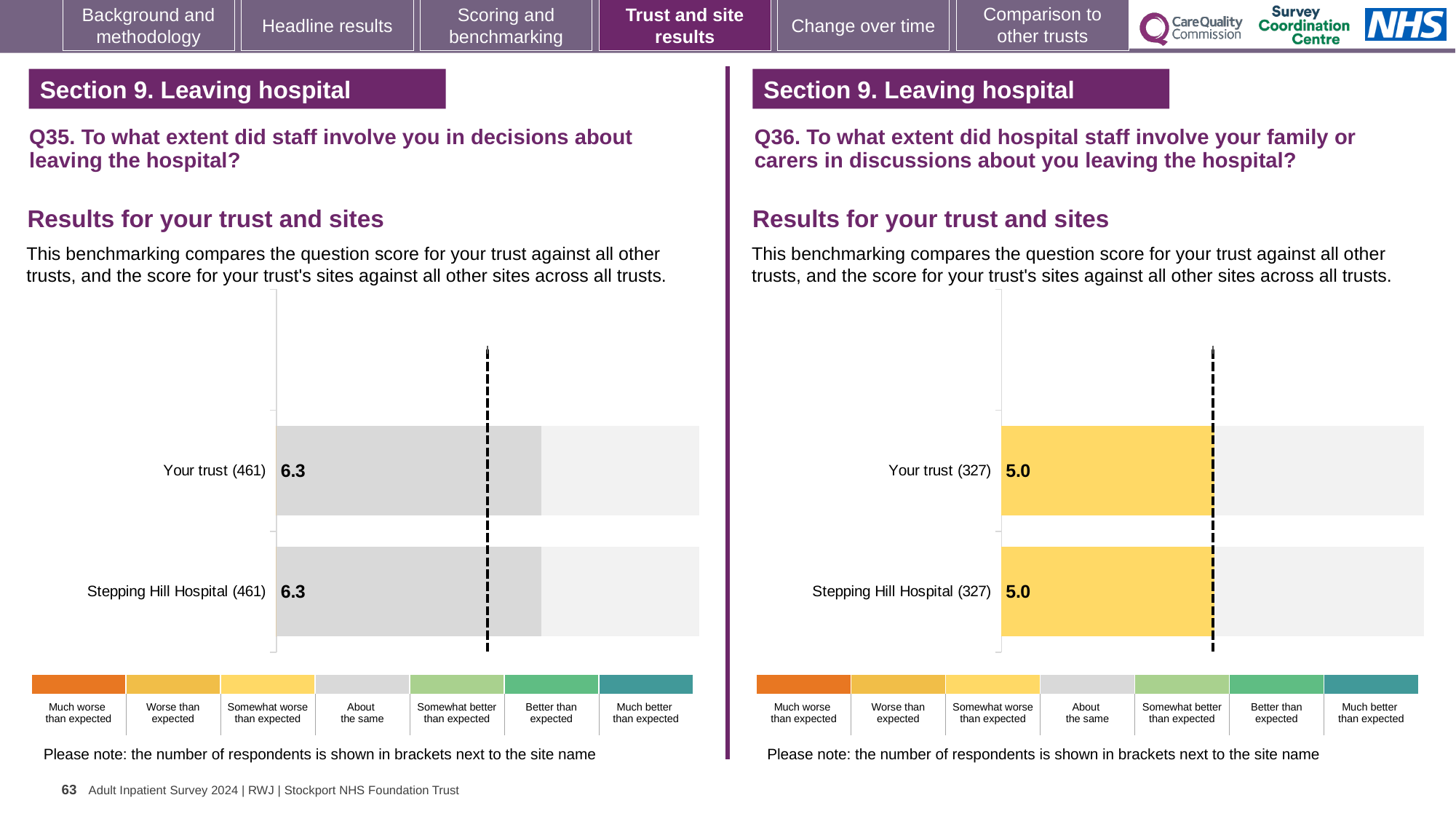
According to the colour key, which benchmark category does the yellow colour of the bars in the Q36 chart on the right represent? Somewhat worse than expected How many bars are plotted in the Q36 chart on the right? 2 What kind of chart is used for the Q35 results on the left? Bar chart In the Q36 chart on the right, what is the score for Your trust? 5.0 In the Q36 chart on the right, what is the difference between the Your trust score and the Stepping Hill Hospital score? 0.0 In the Q36 chart on the right, how many respondents are shown in brackets for Stepping Hill Hospital? 327 In the Q35 chart on the left, what is the score for Your trust? 6.3 In the Q35 chart on the left, what is the difference between the Your trust score and the Stepping Hill Hospital score? 0.0 In the Q35 chart on the left, what is the score for Stepping Hill Hospital? 6.3 How many bars are plotted in the Q35 chart on the left? 2 In the Q35 chart on the left, how many respondents are shown in brackets for Your trust? 461 In the Q36 chart on the right, what is the score for Stepping Hill Hospital? 5.0